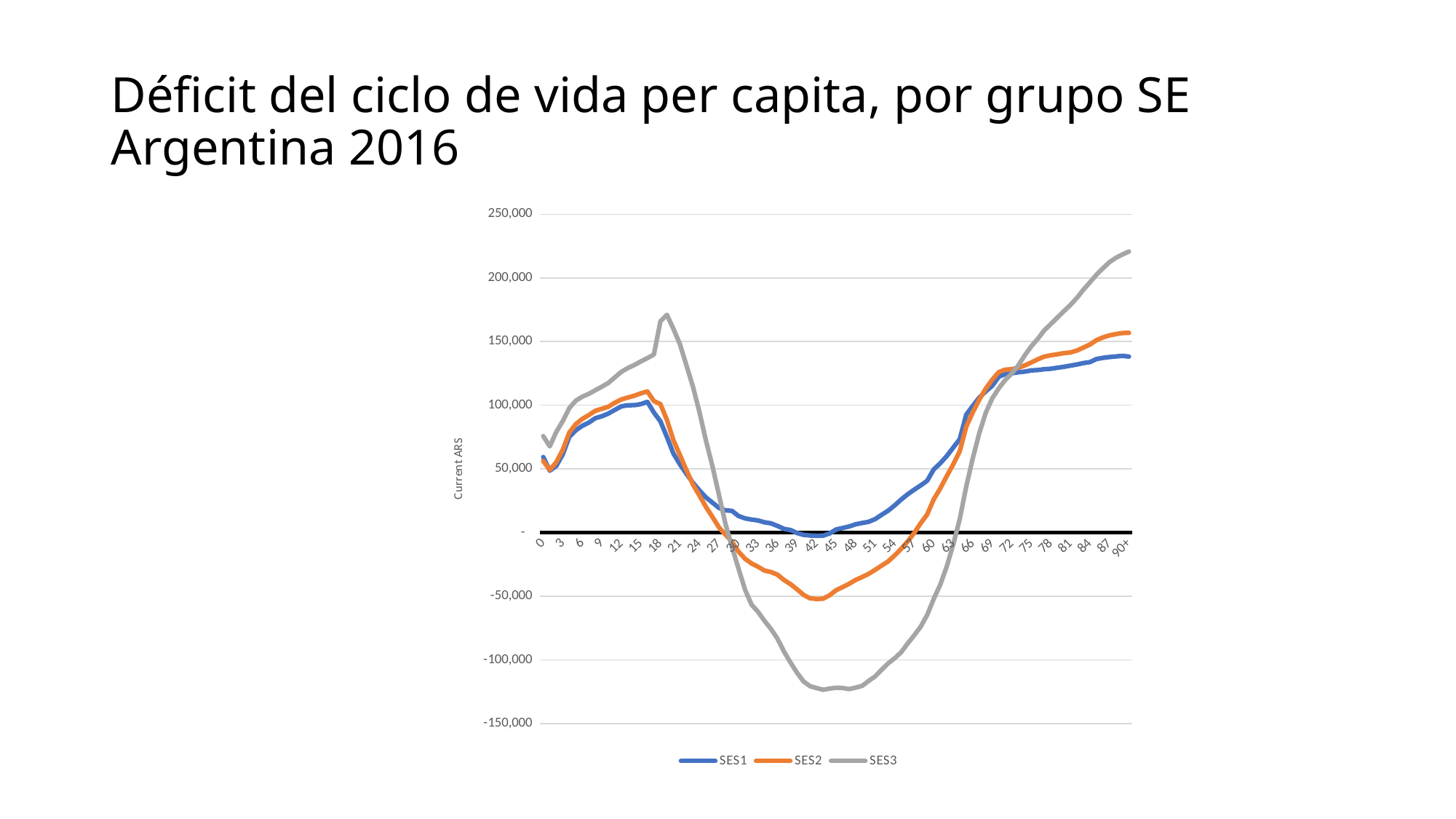
Does the SES3 line rise or fall from age 66 to age 90+? rise What are the names of the three series in the legend? SES1, SES2, SES3 At age 18, which is larger, SES3 or SES1? SES3 Which series has the highest value at age 90+? SES3 Is the value for SES3 at age 90+ greater or less than 200,000? greater What is the label on the vertical axis? Current ARS What kind of chart is shown on the slide? line chart How many series does the legend list? 3 Which series has the lowest value at age 42? SES3 Is the value for SES3 at age 42 greater or less than -100,000? less Is the value for SES1 at age 90+ greater or less than 150,000? less